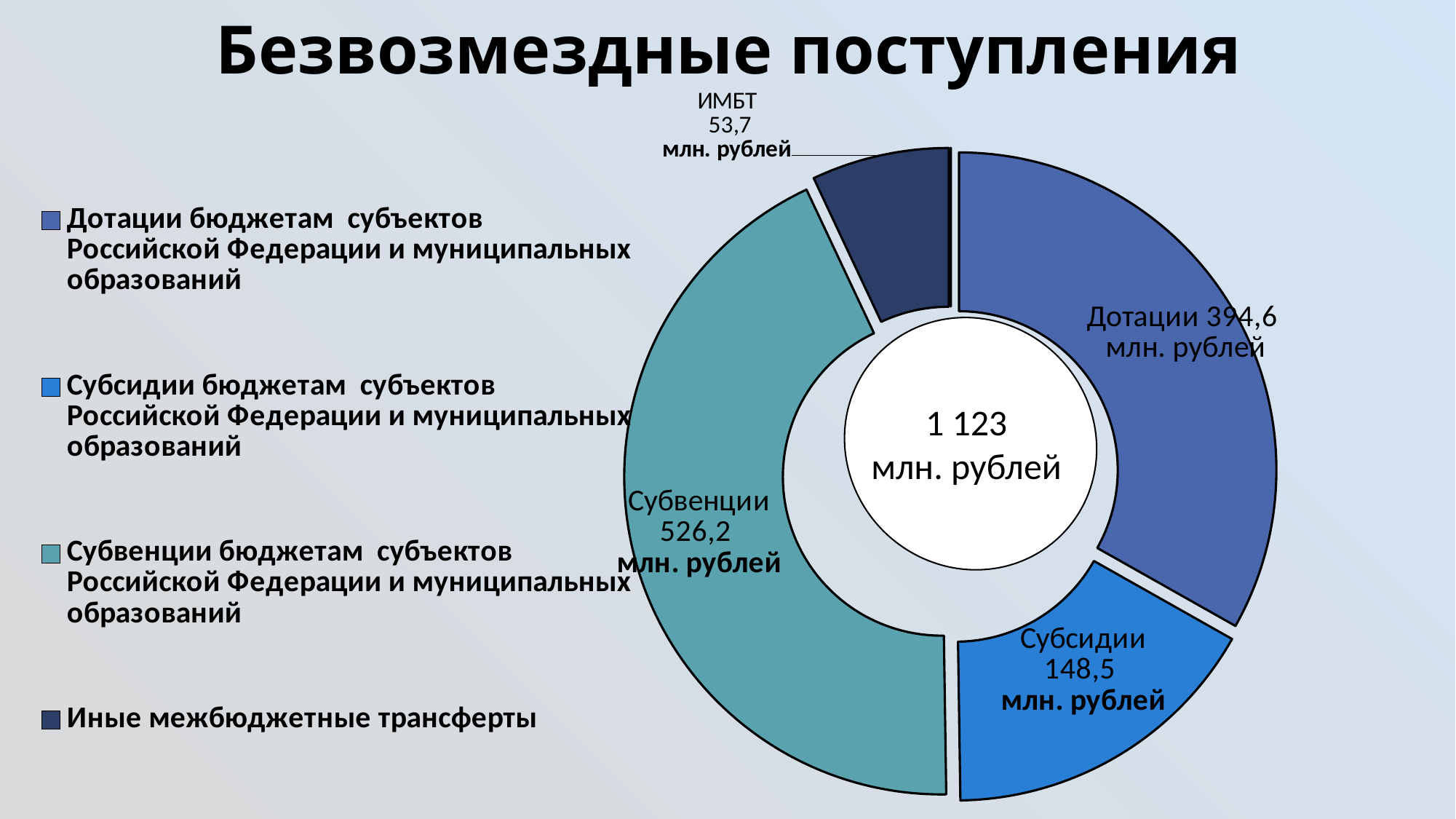
How many categories are shown in the chart? 4 What is the value for Дотации? 394,6 млн. рублей What total value is shown in the centre of the chart? 1 123 млн. рублей What is the difference between Субвенции and Дотации? 131,6 млн. рублей What is the value for ИМБТ? 53,7 млн. рублей What is the value for Субсидии? 148,5 млн. рублей What kind of chart is shown on the slide? Doughnut chart What is the value for Субвенции? 526,2 млн. рублей Which category has the smallest value? ИМБТ Which is larger, Дотации or Субсидии? Дотации What is the difference between Субсидии and ИМБТ? 94,8 млн. рублей Which category has the largest value? Субвенции